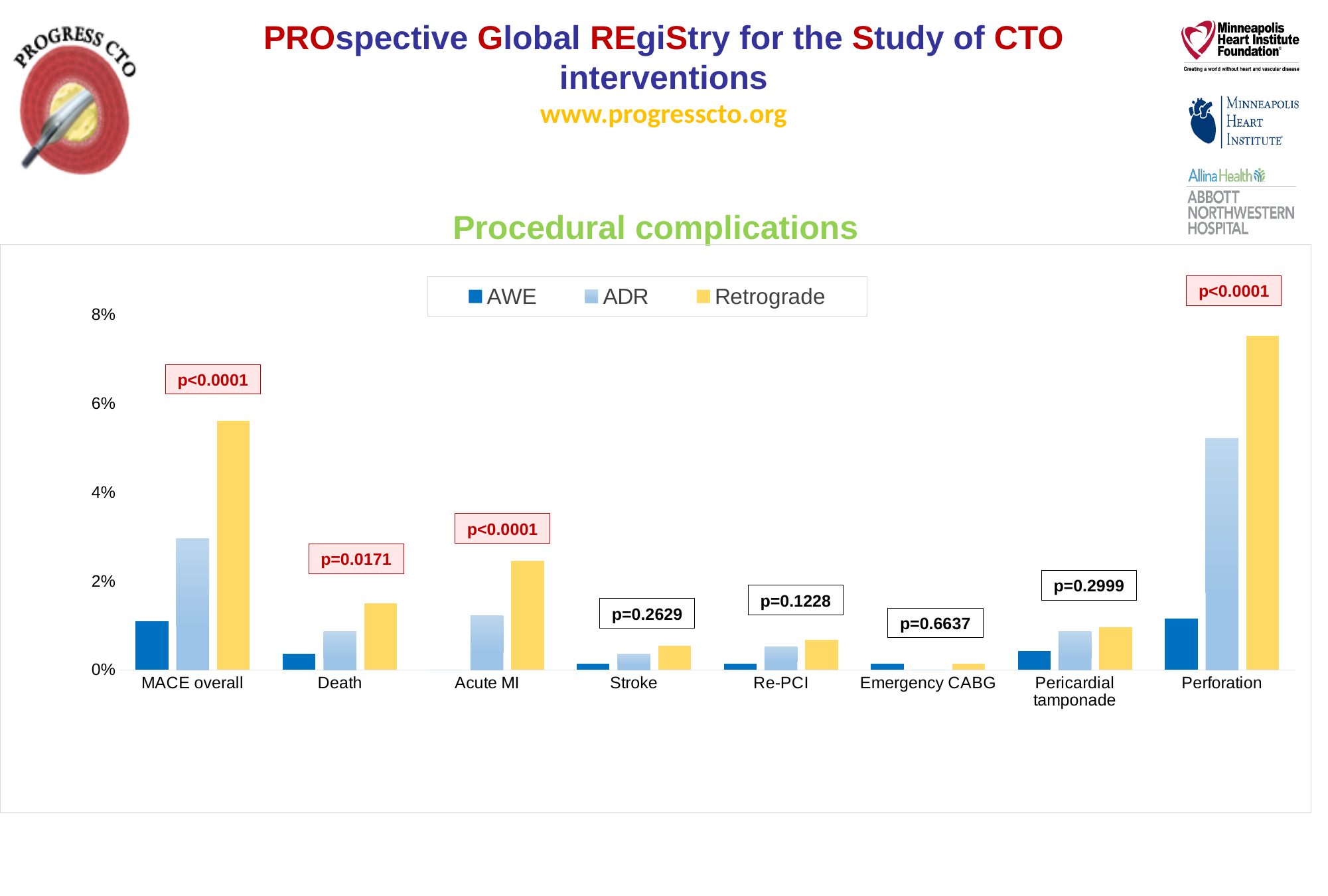
Is the ADR value for MACE overall greater or less than 4%? less What kind of chart is shown on the slide? bar chart Which series has the highest bar for Death? Retrograde Is the Retrograde value for Perforation greater or less than 6%? greater What p-value is shown above the Death bars? p=0.0171 For Perforation, which is larger: the AWE value or the ADR value? ADR Which category has the highest Retrograde bar? Perforation Is the Retrograde value for MACE overall greater or less than 4%? greater How many series does the legend list? 3 For MACE overall, which is larger: the ADR value or the Retrograde value? Retrograde How many complication categories are shown on the x axis? 8